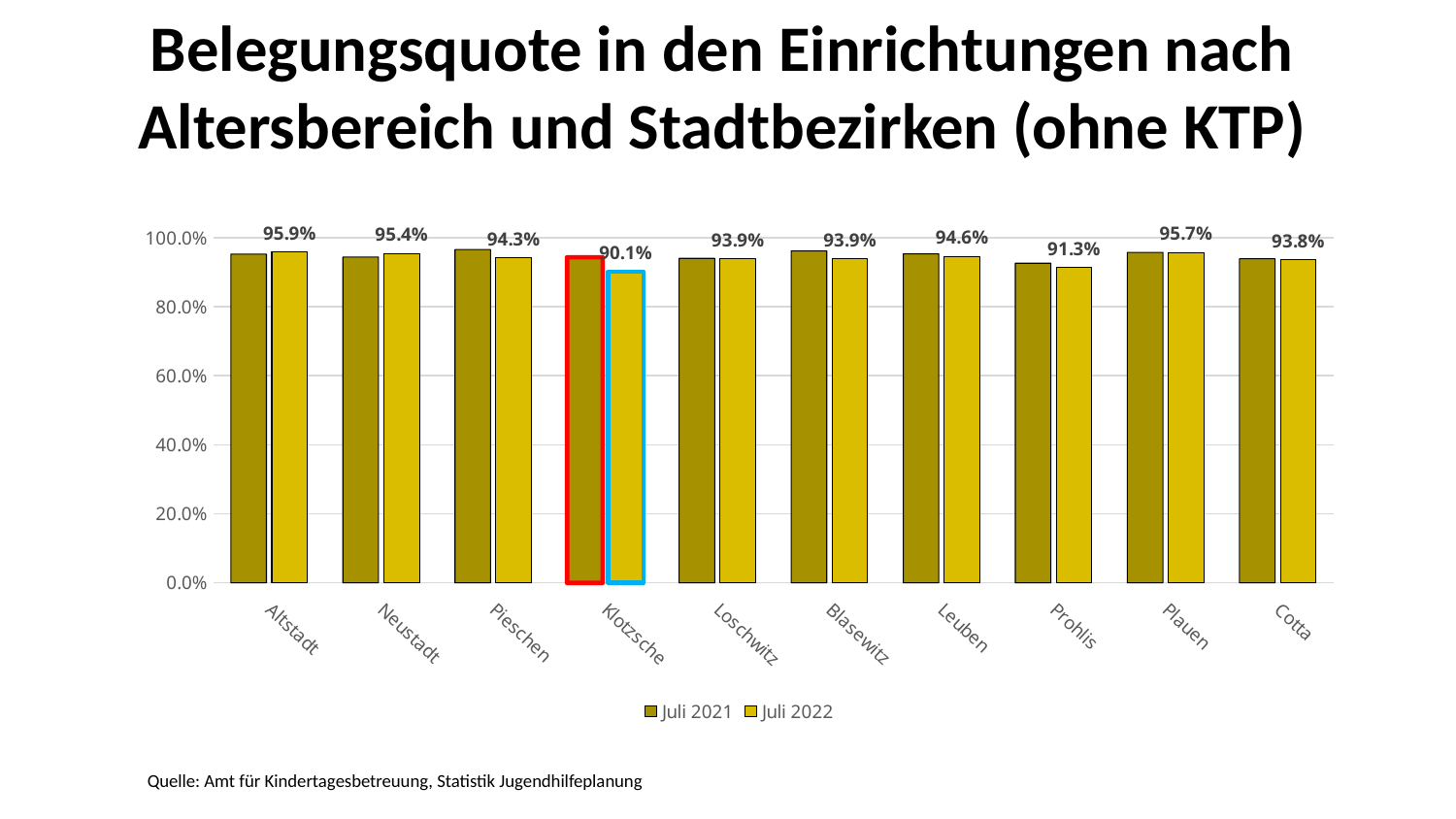
Which Stadtbezirk has the highest Juli 2022 value? Altstadt What is the Juli 2022 value for Klotzsche? 90.1% What is the difference between the Juli 2022 values for Altstadt and Klotzsche? 5.8 percentage points Which Stadtbezirk has the lowest Juli 2022 value? Klotzsche What is the Juli 2022 value for Altstadt? 95.9% What kind of chart is shown on the slide? Bar chart How many Stadtbezirke are shown on the x axis? 10 Which has the larger Juli 2022 value, Neustadt or Pieschen? Neustadt What is the Juli 2022 value for Prohlis? 91.3% What are the two series named in the legend? Juli 2021 and Juli 2022 How many series does the legend list? 2 Is the Juli 2021 value for Klotzsche greater or less than 80.0%? greater